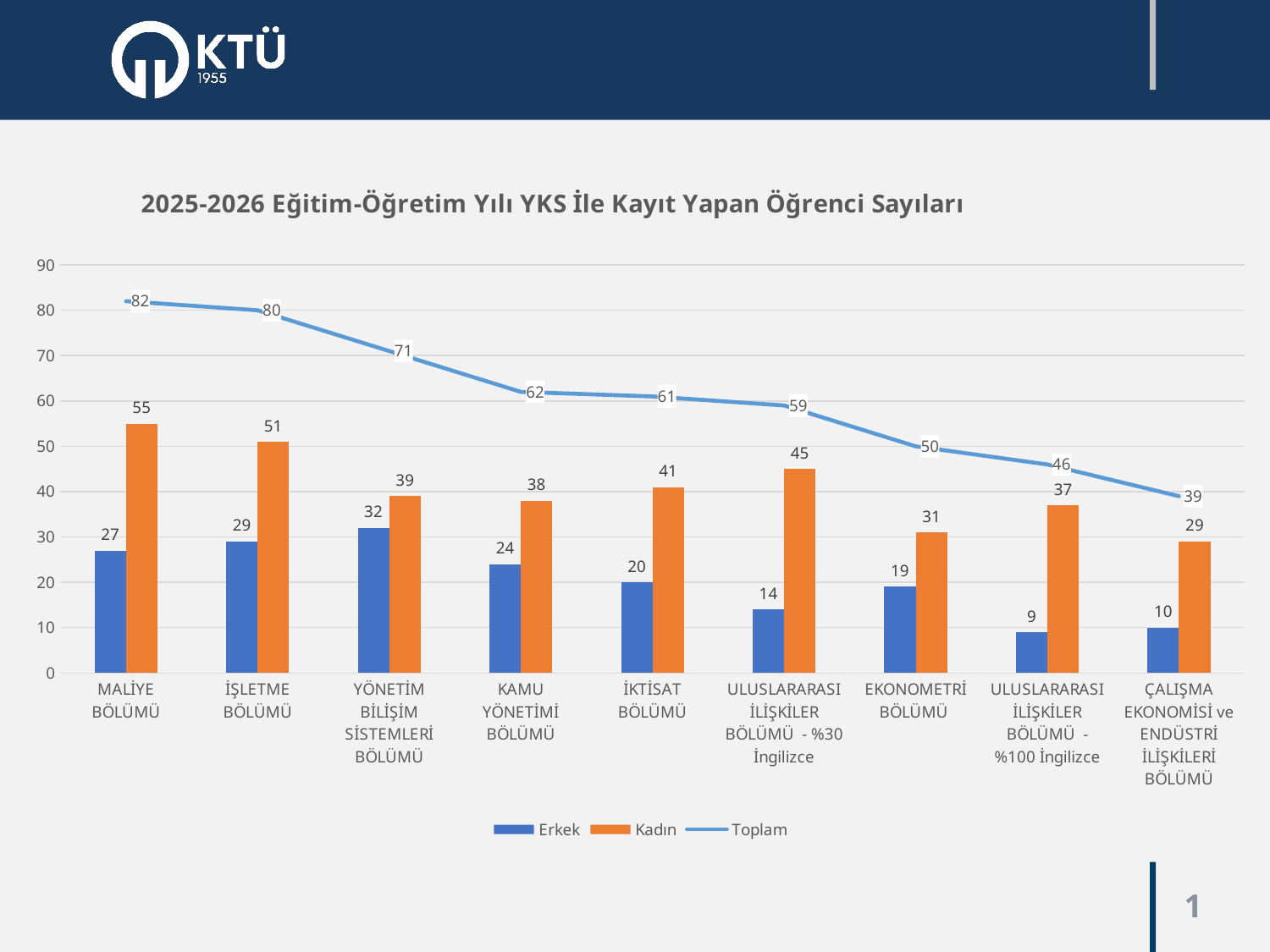
Which department has the highest Toplam value? MALİYE BÖLÜMÜ Which department has the lowest Erkek value? ULUSLARARASI İLİŞKİLER BÖLÜMÜ - %100 İngilizce What is the title of the chart? 2025-2026 Eğitim-Öğretim Yılı YKS İle Kayıt Yapan Öğrenci Sayıları Which is larger for EKONOMETRİ BÖLÜMÜ, the Erkek value or the Kadın value? Kadın What is the Kadın value for İKTİSAT BÖLÜMÜ? 41 How many series does the legend list? 3 What is the Toplam value for YÖNETİM BİLİŞİM SİSTEMLERİ BÖLÜMÜ? 71 What is the Erkek value for MALİYE BÖLÜMÜ? 27 What kind of chart is this? Combined bar and line chart How many departments are shown on the x axis? 9 Does the Toplam line rise or fall from left to right along the x axis? Fall What is the difference between the Kadın and Erkek values for ULUSLARARASI İLİŞKİLER BÖLÜMÜ - %30 İngilizce? 31